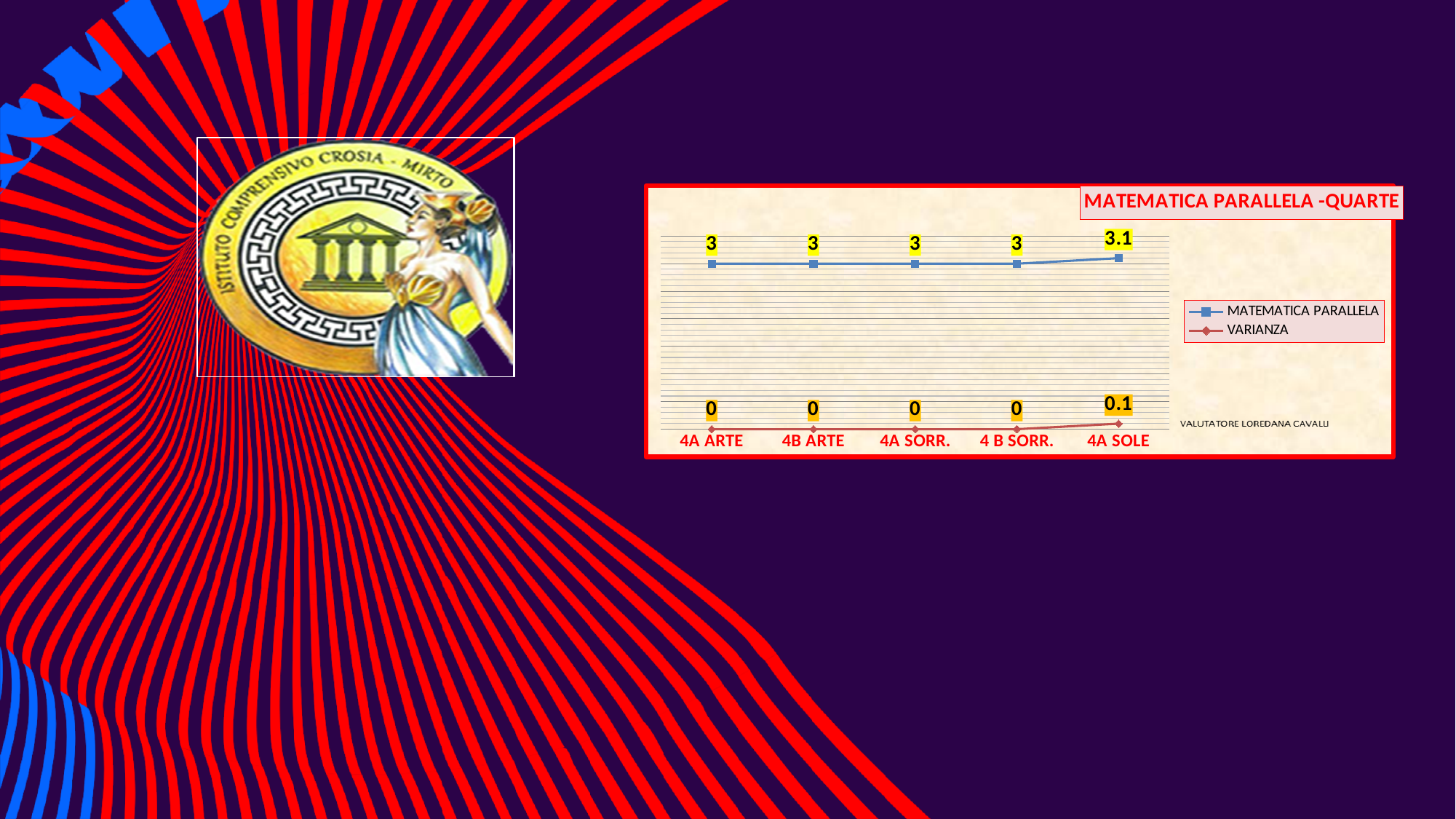
Which is larger, the MATEMATICA PARALLELA value for 4A SOLE or for 4A ARTE? 4A SOLE Which category has the highest VARIANZA value? 4A SOLE How many categories are shown on the x axis? 5 Which category has the highest MATEMATICA PARALLELA value? 4A SOLE What kind of chart is shown? Line chart What is the VARIANZA value for 4A SORR.? 0 What is the difference between the MATEMATICA PARALLELA values for 4A SOLE and 4 B SORR.? 0.1 What is the MATEMATICA PARALLELA value for 4B ARTE? 3 How many series does the legend list? 2 What is the MATEMATICA PARALLELA value for 4A SOLE? 3.1 What is the title of the chart? MATEMATICA PARALLELA -QUARTE What is the VARIANZA value for 4A SOLE? 0.1